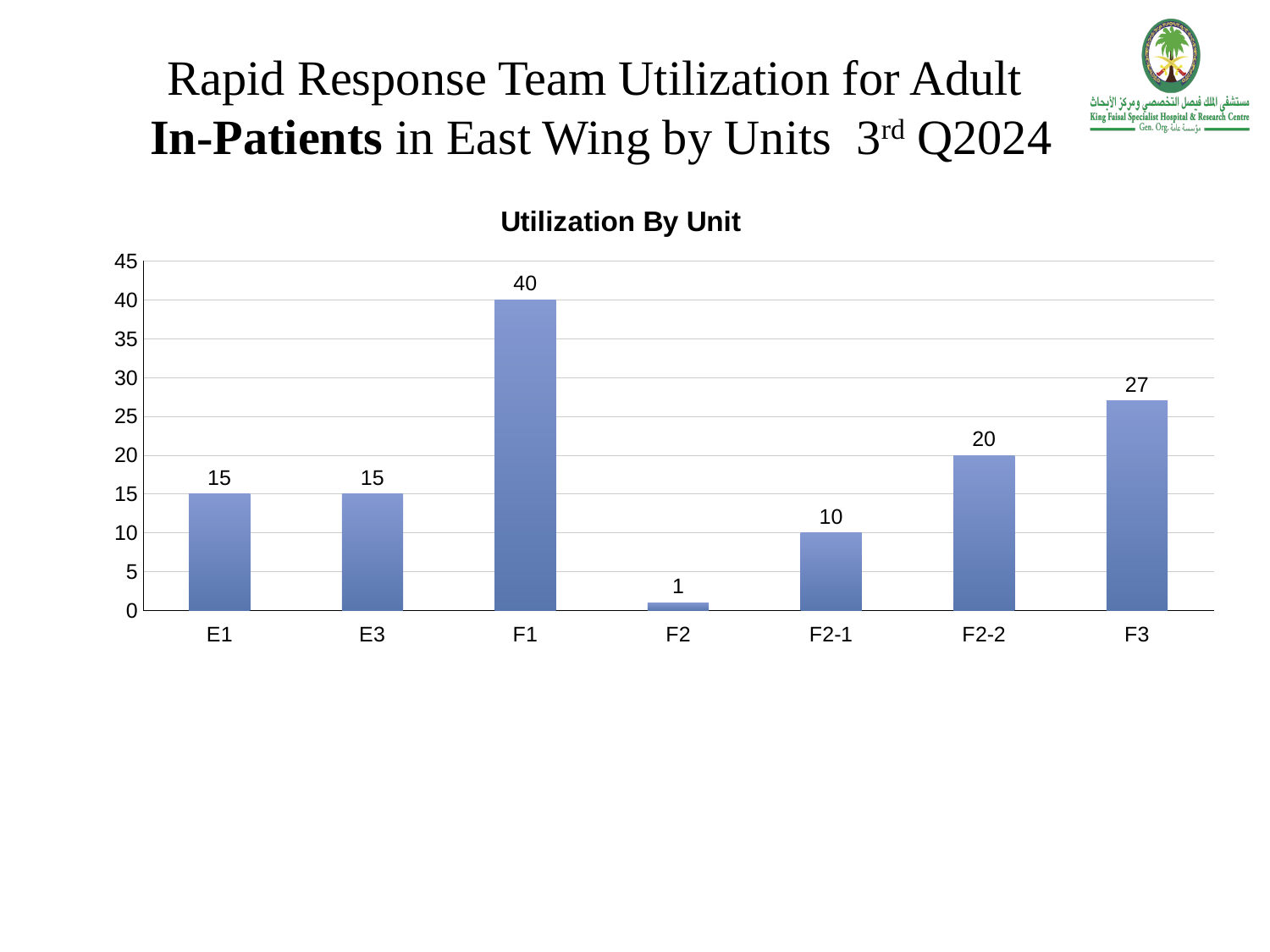
What is the difference between the values for F1 and F3? 13 Which unit has the lowest utilization? F2 What kind of chart is shown on the slide? Bar chart Which is larger, the value for F2-2 or the value for F3? F3 Which unit has the highest utilization? F1 What is the value for F2? 1 What is the difference between the values for F2-2 and F2-1? 10 What is the value for F3? 27 What is the value for F1? 40 What is the value for F2-2? 20 Is the value for F1 greater or less than 35? greater How many units are shown on the x axis? 7